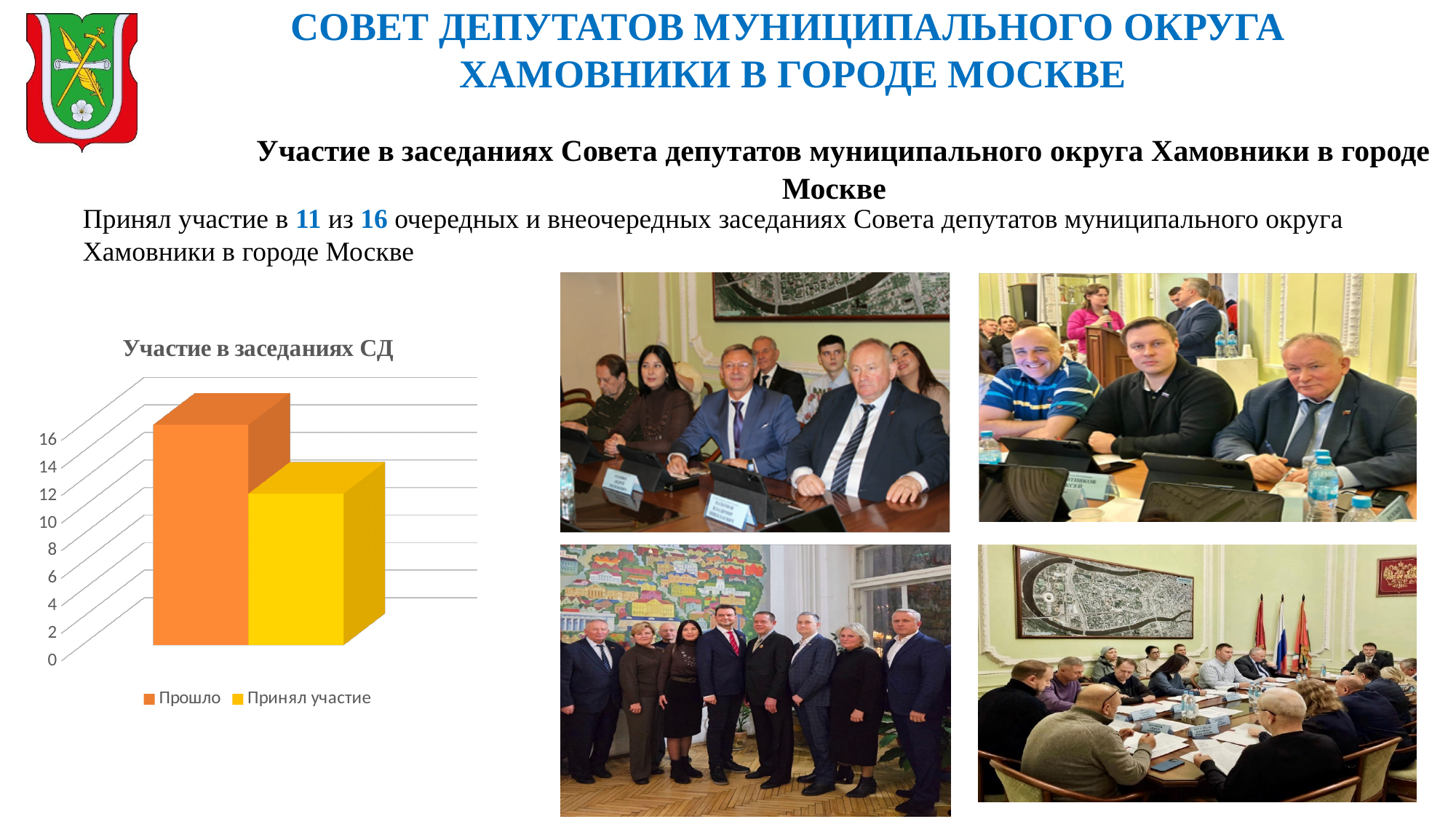
Is the value for Принял участие greater or less than 14? less Which series has the taller bar in the chart? Прошло Which series has the shorter bar in the chart? Принял участие How many bars are plotted in the chart? 2 What is the value of the Прошло bar in the chart? 16 What kind of chart is shown on the slide? bar chart How many series does the chart legend list? 2 What is the title of the chart? Участие в заседаниях СД What is the highest value shown on the chart's vertical axis? 16 Is the bar for Прошло taller or shorter than the bar for Принял участие? taller Is the value for Принял участие greater or less than 10? greater Which series is shown in orange in the chart? Прошло